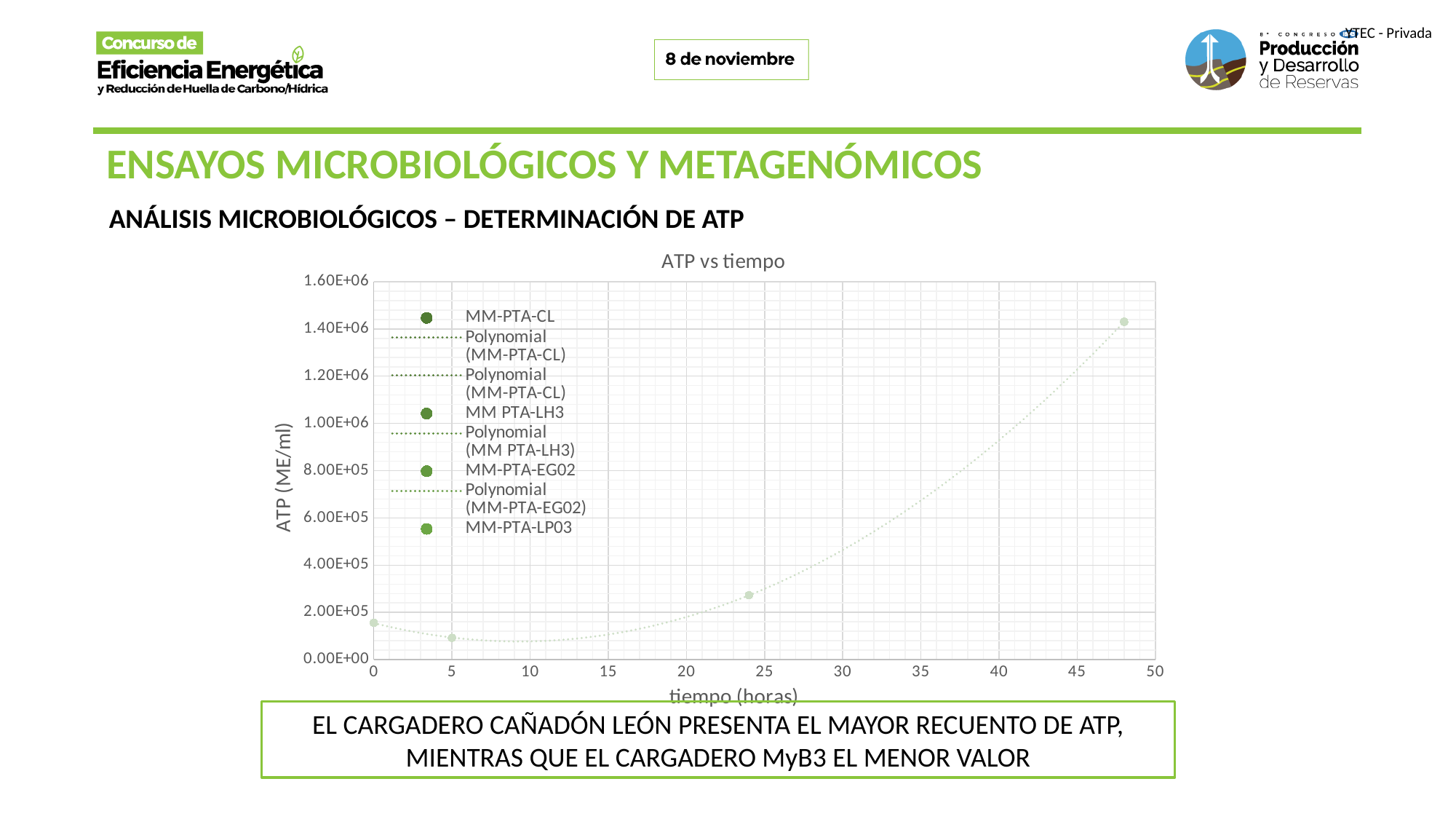
What is the title of the chart? ATP vs tiempo How many data points are plotted on the chart? 4 What is the label of the y axis of the chart? ATP (ME/ml) At which time (in hours) is the plotted ATP value highest? 48 Which has the larger ATP value, the point at 24 hours or the point at 48 hours? 48 hours How many entries does the chart's legend list? 8 Between 24 and 48 hours, does the plotted ATP value rise or fall? rise At which time (in hours) is the plotted ATP value lowest? 5 Is the ATP value at 0 hours greater or less than 2.00E+05? less What kind of chart is shown on the slide? scatter chart Is the ATP value at 48 hours greater or less than 1.20E+06? greater Is the ATP value at 24 hours greater or less than 4.00E+05? less